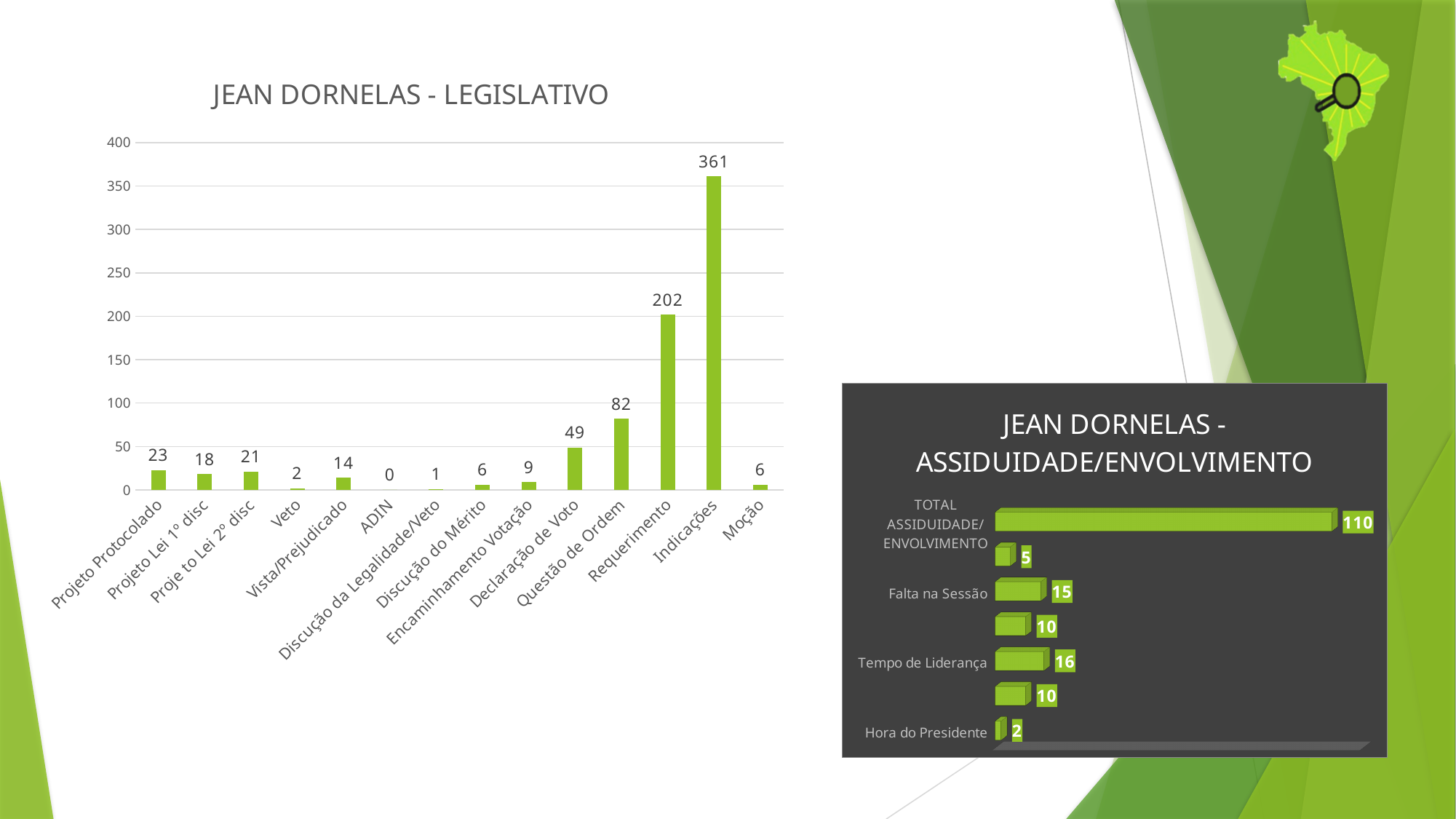
What kind of chart is "JEAN DORNELAS - LEGISLATIVO"? Bar chart In the chart titled "JEAN DORNELAS - ASSIDUIDADE/ENVOLVIMENTO", what is the value for Tempo de Liderança? 16 In the chart titled "JEAN DORNELAS - ASSIDUIDADE/ENVOLVIMENTO", what is the difference between Falta na Sessão and Hora do Presidente? 13 In the chart titled "JEAN DORNELAS - LEGISLATIVO", which category has the highest value? Indicações In the chart titled "JEAN DORNELAS - ASSIDUIDADE/ENVOLVIMENTO", what is the value for TOTAL ASSIDUIDADE/ENVOLVIMENTO? 110 In the chart titled "JEAN DORNELAS - LEGISLATIVO", which category has the lowest value? ADIN In the chart titled "JEAN DORNELAS - LEGISLATIVO", what is the value for Declaração de Voto? 49 In the chart titled "JEAN DORNELAS - LEGISLATIVO", what is the value for Requerimento? 202 How many categories are shown in the chart titled "JEAN DORNELAS - LEGISLATIVO"? 14 In the chart titled "JEAN DORNELAS - LEGISLATIVO", which is larger, Projeto Protocolado or Projeto Lei 1° disc? Projeto Protocolado In the chart titled "JEAN DORNELAS - LEGISLATIVO", what is the value for Indicações? 361 In the chart titled "JEAN DORNELAS - LEGISLATIVO", what is the difference between the values for Indicações and Requerimento? 159